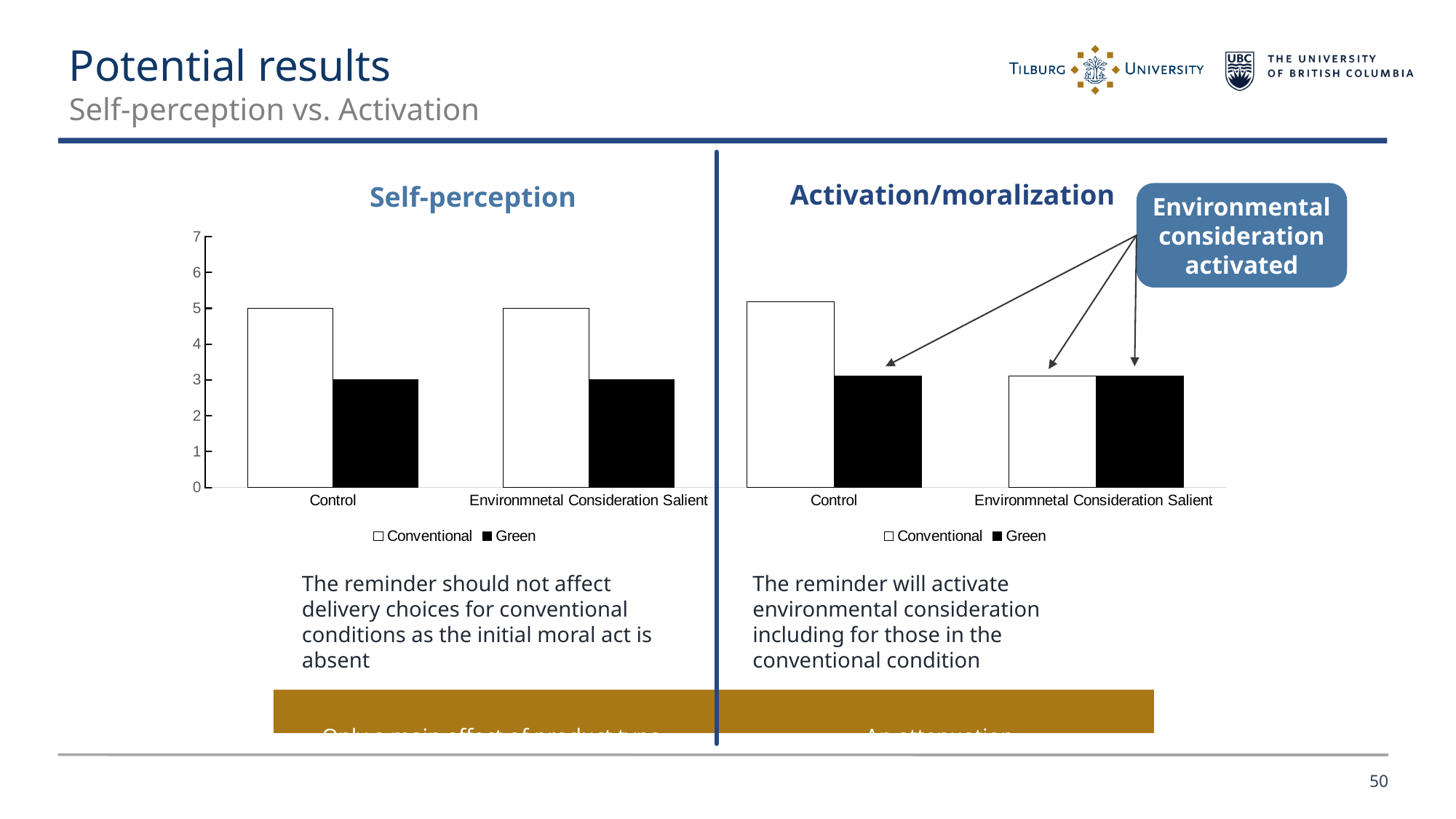
In the Self-perception chart, what is the difference between the Conventional and Green values in the Control condition? 2 In the Self-perception chart, what is the value for Green in the Control condition? 3 In the Activation/moralization chart, which series is larger in the Control condition, Conventional or Green? Conventional In the Activation/moralization chart, is the value for Green in the Control condition greater or less than 4? less How many series does the legend of the Activation/moralization chart list? 2 In the Self-perception chart, what is the value for Conventional in the Control condition? 5 In the Activation/moralization chart, is the value for Conventional in the Control condition greater or less than 4? greater How many categories are shown on the x axis of the Activation/moralization chart? 2 What colour are the Green series bars in the Self-perception chart? black What kind of chart is the Self-perception chart? bar chart In the Self-perception chart, which series is larger in the Environmnetal Consideration Salient condition, Conventional or Green? Conventional In the Self-perception chart, what is the value for Conventional in the Environmnetal Consideration Salient condition? 5